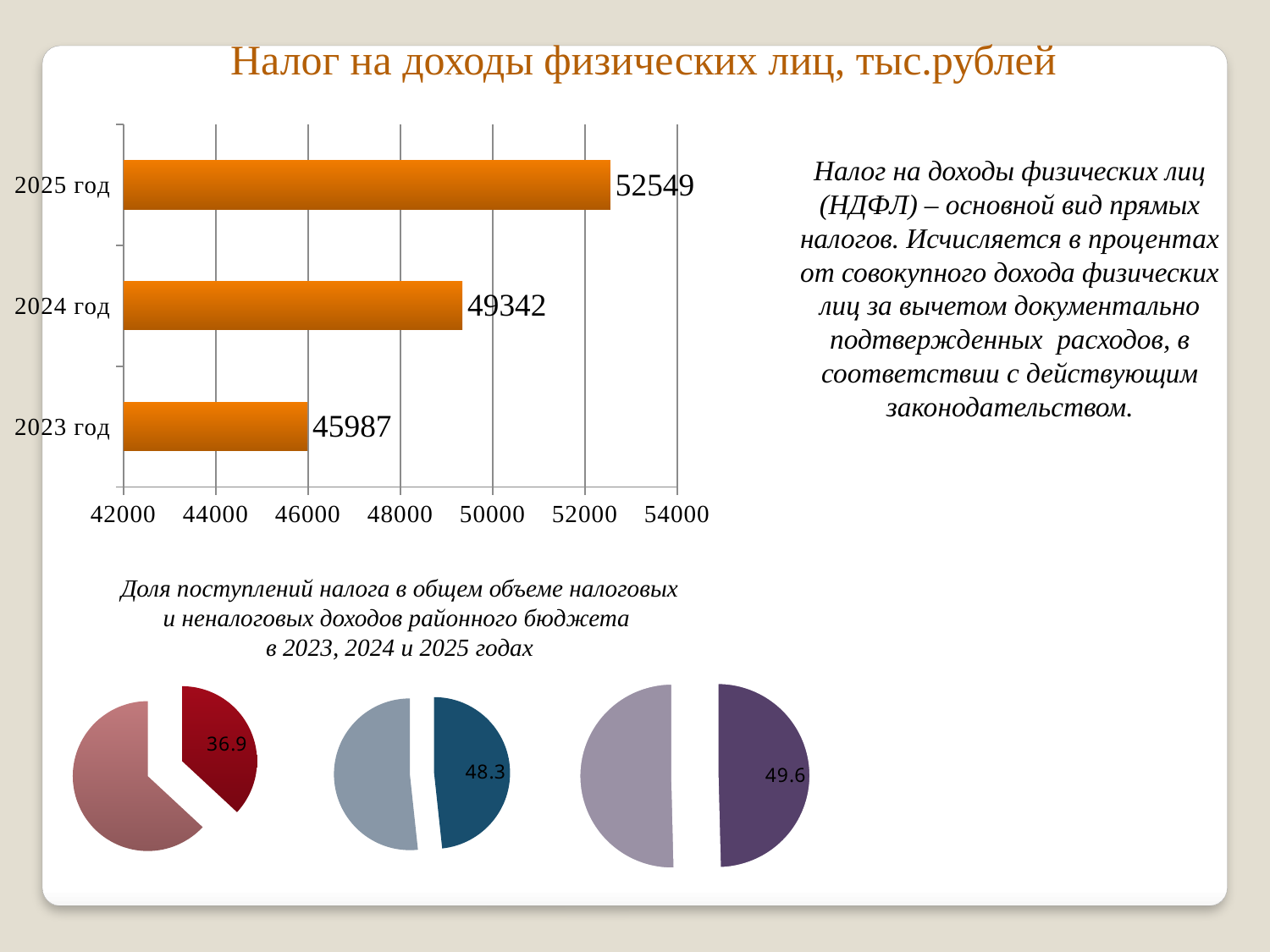
In the rightmost pie chart at the bottom of the slide, what value is labelled on the dark purple slice? 49.6 In the bar chart, what is the value for 2025 год? 52549 In the bar chart, what is the difference between the values for 2025 год and 2024 год? 3207 In the bar chart, what is the value for 2024 год? 49342 In the bar chart, which year has the highest value? 2025 год In the bar chart, which is larger: the value for 2024 год or 2023 год? 2024 год In the leftmost pie chart at the bottom of the slide, what value is labelled on the dark red slice? 36.9 In the bar chart, what is the value for 2023 год? 45987 In the bar chart, what is the difference between the values for 2024 год and 2023 год? 3355 What type of chart is the chart at the top left of the slide? bar chart How many bars are shown in the bar chart? 3 In the bar chart, which year has the lowest value? 2023 год